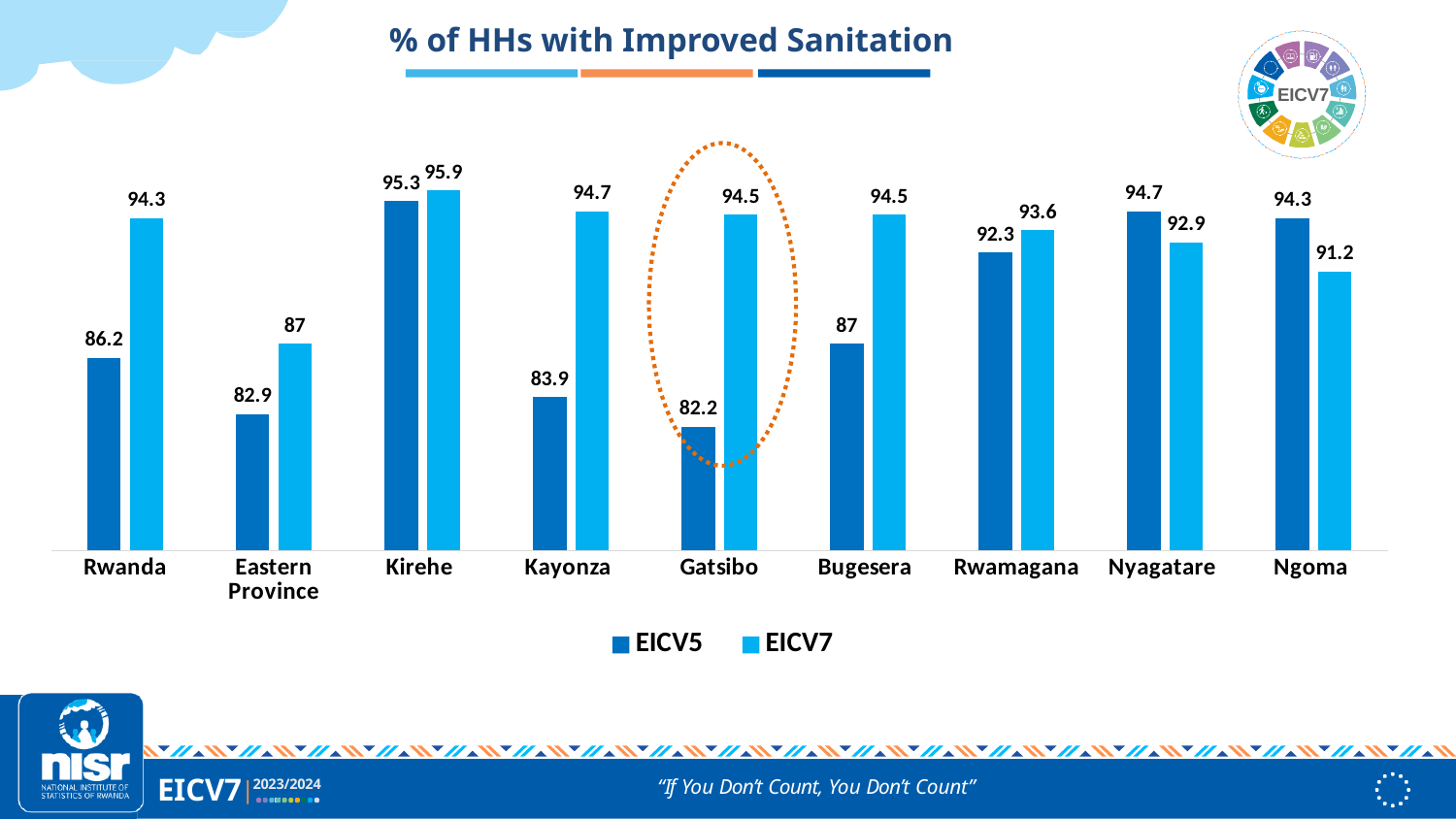
What is the EICV5 value for Eastern Province? 82.9 How many categories are shown on the x axis? 9 What kind of chart is shown on the slide? Bar chart What is the EICV7 value for Gatsibo? 94.5 Which category has the highest EICV7 value? Kirehe What is the difference between the EICV7 and EICV5 values for Gatsibo? 12.3 Which category has the lowest EICV7 value? Eastern Province Which category has the lowest EICV5 value? Gatsibo How many series does the legend list? 2 What is the difference between the EICV7 and EICV5 values for Rwanda? 8.1 What is the EICV7 value for Ngoma? 91.2 For Nyagatare, which is larger: the EICV5 value or the EICV7 value? EICV5